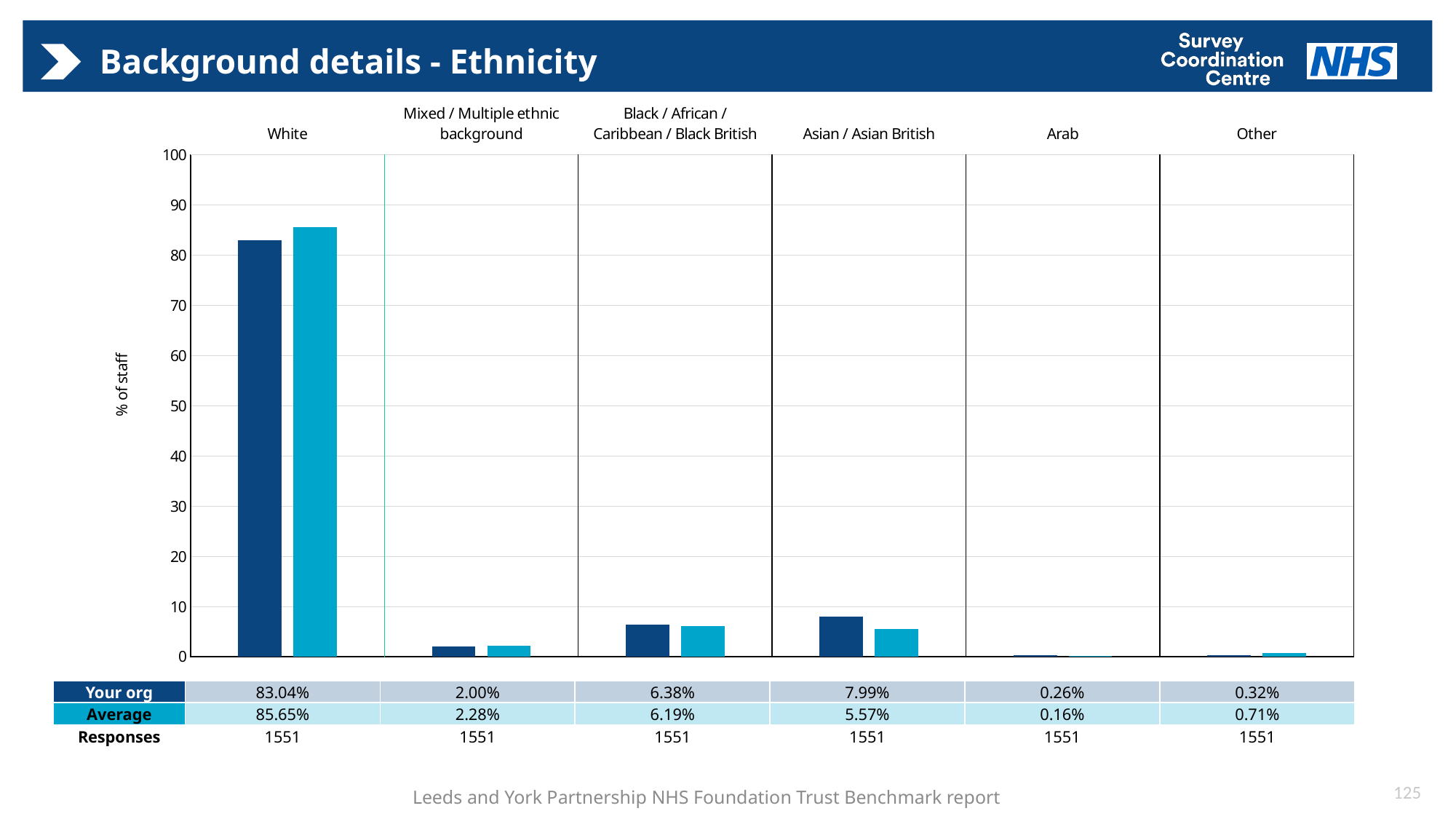
What is the 'Your org' value for Arab? 0.26% What is the 'Your org' value for White? 83.04% How many ethnicity categories are shown on the chart? 6 Is the 'Your org' value for White greater or less than 80? greater For Asian / Asian British, which is larger: 'Your org' or Average? Your org Which ethnicity category has the highest 'Your org' value? White Which ethnicity category has the lowest Average value? Arab What is the number of responses for the Other category? 1551 What is the Average value for Asian / Asian British? 5.57% What kind of chart is shown on the slide? bar chart What is the difference between the Average and 'Your org' values for White? 2.61% How many series does the chart show? 2